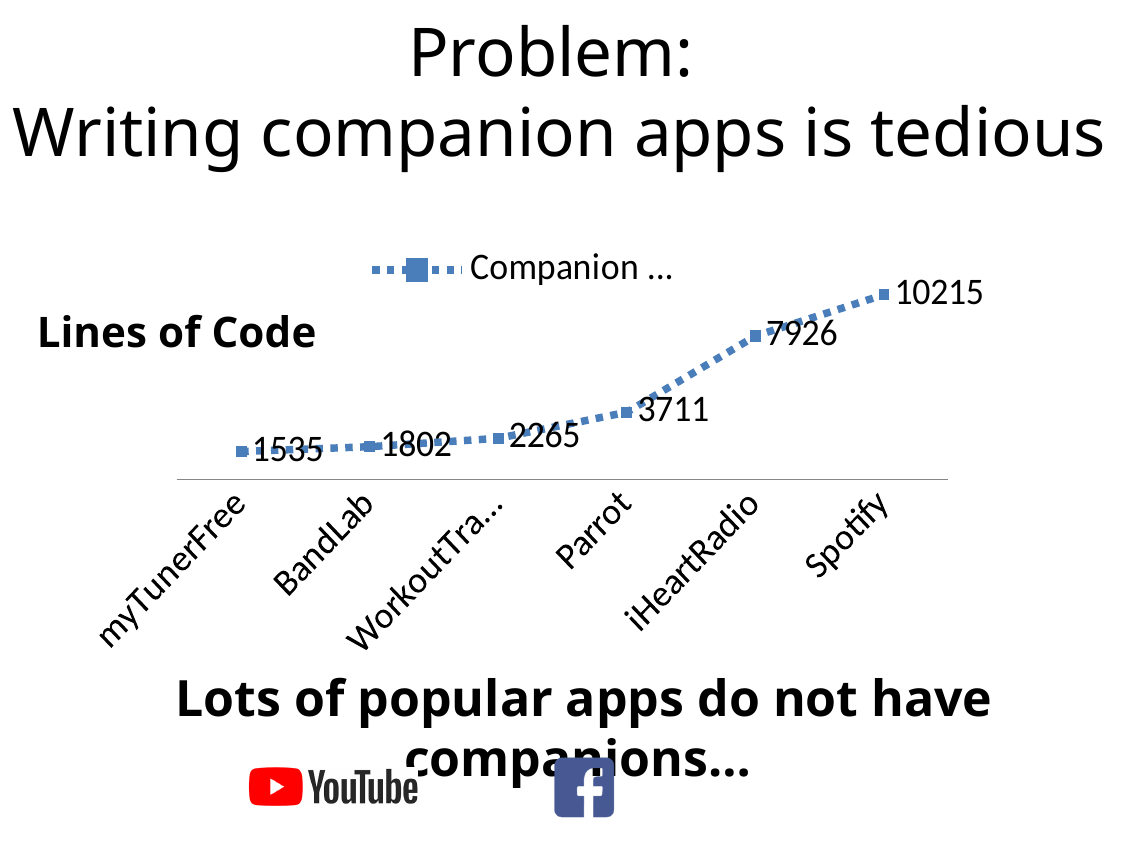
What is the number of lines of code for myTunerFree? 1535 Do the values rise or fall from left to right along the x axis? rise What kind of chart is shown on the slide? line chart What is the number of lines of code for Parrot? 3711 What is the number of lines of code for BandLab? 1802 What is the number of lines of code for iHeartRadio? 7926 Which app has the highest number of lines of code? Spotify What is the number of lines of code for Spotify? 10215 Which app has the lowest number of lines of code? myTunerFree How many apps are plotted on the chart? 6 Which has more lines of code, iHeartRadio or Parrot? iHeartRadio What is the difference in lines of code between Spotify and iHeartRadio? 2289